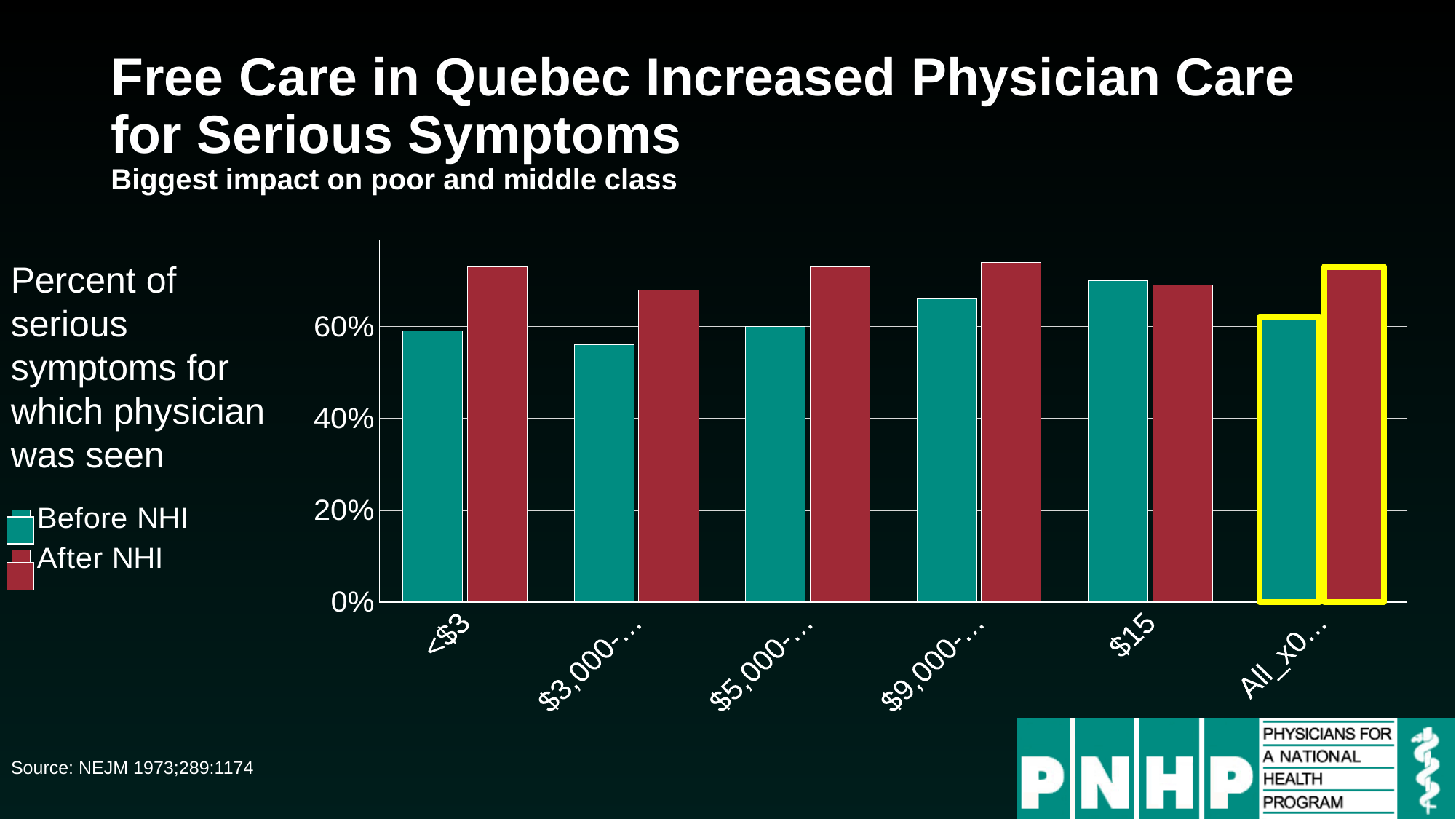
For the "$5,000-…" category, which is larger: Before NHI or After NHI? After NHI How many series does the legend list? 2 What kind of chart is shown on the slide? bar chart For the "$3,000-…" category, which is larger: Before NHI or After NHI? After NHI Is the After NHI value for "<$3" greater or less than 60%? greater Is the After NHI value for "$3,000-…" greater or less than 40%? greater For the "<$3" category, which is larger: Before NHI or After NHI? After NHI What are the two legend entries? Before NHI and After NHI Which series is shown in teal? Before NHI Is the Before NHI value for "$3,000-…" greater or less than 60%? less How many categories are shown along the x axis? 6